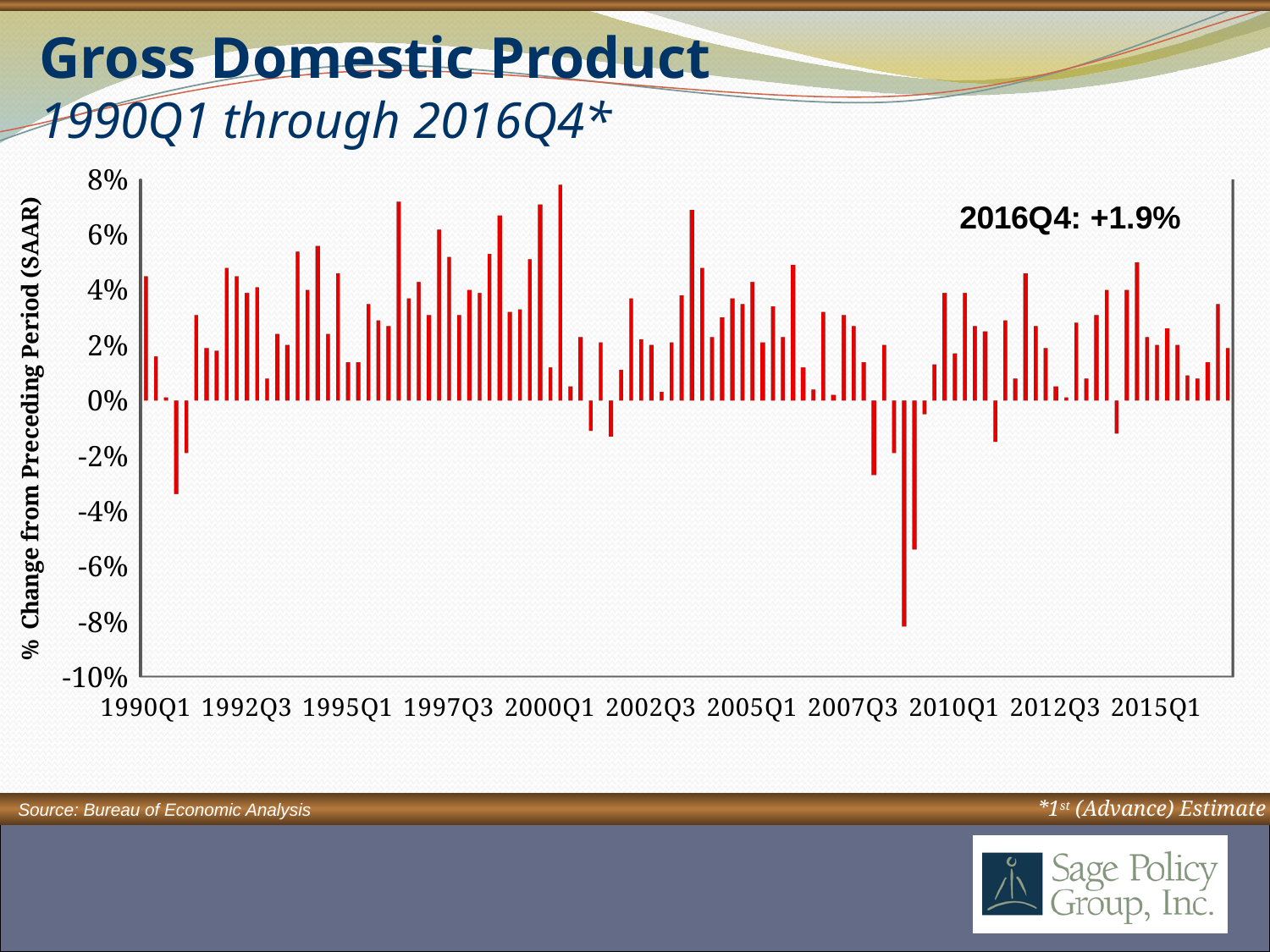
What is the value shown for 2016Q4? +1.9% What is the first quarter label shown on the x axis? 1990Q1 How many quarter labels are printed along the x axis? 11 What is the title of the chart? Gross Domestic Product Is the lowest value on the chart greater or less than -6%? less What is the label on the vertical axis of the chart? % Change from Preceding Period (SAAR) What is the highest tick value shown on the vertical axis? 8% Is the value for 2010Q1 greater or less than 0%? greater Is the value for 2016Q4 greater or less than 2%? less What kind of chart is shown on the slide? bar chart